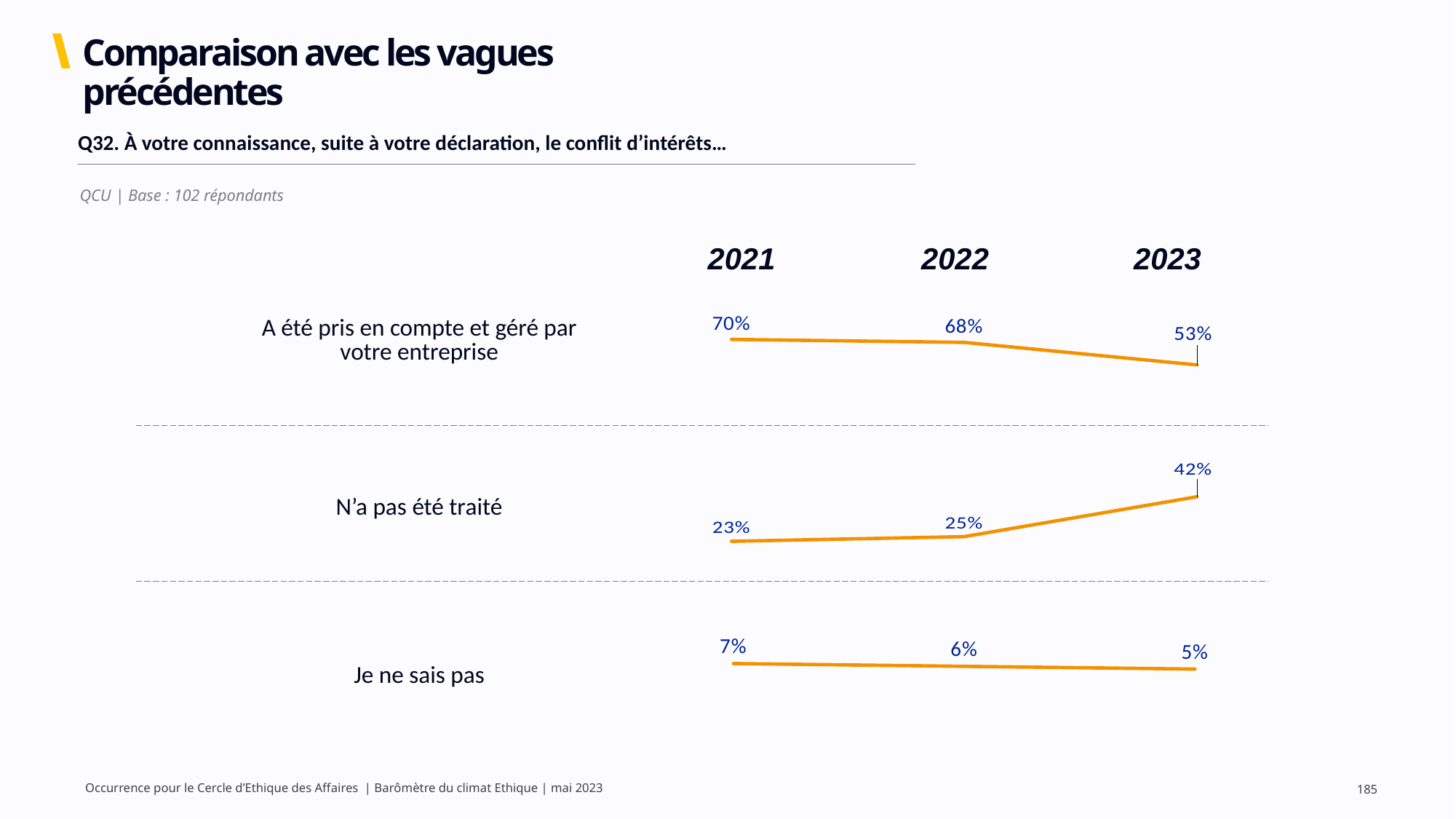
In the line chart for 'A été pris en compte et géré par votre entreprise', do the values rise or fall from 2021 to 2023? fall In the line chart for 'N'a pas été traité', what is the value for 2021? 23% In the line chart for 'Je ne sais pas', what is the value for 2022? 6% In the line chart for 'N'a pas été traité', do the values rise or fall from 2021 to 2023? rise What kind of chart is used to show the values for each response on the slide? line chart In the line chart for 'A été pris en compte et géré par votre entreprise', which year has the highest value? 2021 In the line chart for 'A été pris en compte et géré par votre entreprise', what is the value for 2023? 53% In the line chart for 'N'a pas été traité', which year has the lowest value? 2021 In the line chart for 'N'a pas été traité', what is the difference between the 2023 and 2022 values? 17 percentage points In the line chart for 'A été pris en compte et géré par votre entreprise', what is the difference between the 2021 and 2023 values? 17 percentage points How many years are plotted in each line chart on the slide? 3 In the line chart for 'Je ne sais pas', which is larger, the value for 2021 or the value for 2023? 2021